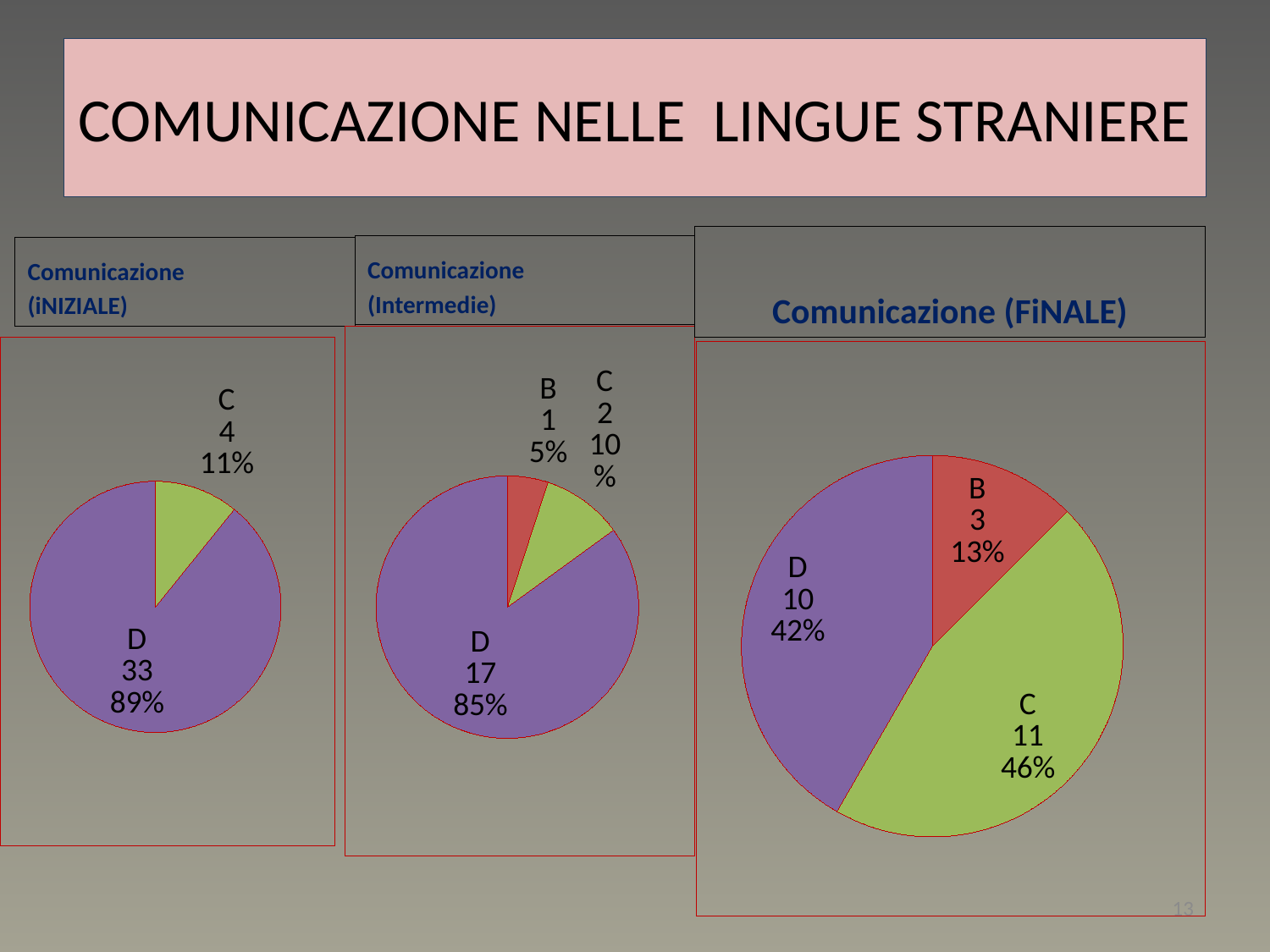
In the Comunicazione (iNIZIALE) chart, what is the value for D? 33 In the Comunicazione (FiNALE) chart, what is the value for C? 11 In the Comunicazione (iNIZIALE) chart, which is larger, the value for C or the value for D? D In the Comunicazione (FiNALE) chart, which category has the largest slice? C How many categories are shown in the Comunicazione (Intermedie) chart? 3 In the Comunicazione (iNIZIALE) chart, what share of the pie does C have? 11% In the Comunicazione (Intermedie) chart, which category has the smallest slice? B In the Comunicazione (FiNALE) chart, what is the difference between the values for C and D? 1 In the Comunicazione (Intermedie) chart, what is the value for B? 1 In the Comunicazione (Intermedie) chart, what share of the pie does D have? 85% In the Comunicazione (FiNALE) chart, what share of the pie does B have? 13% What kind of chart is the Comunicazione (FiNALE) chart? Pie chart